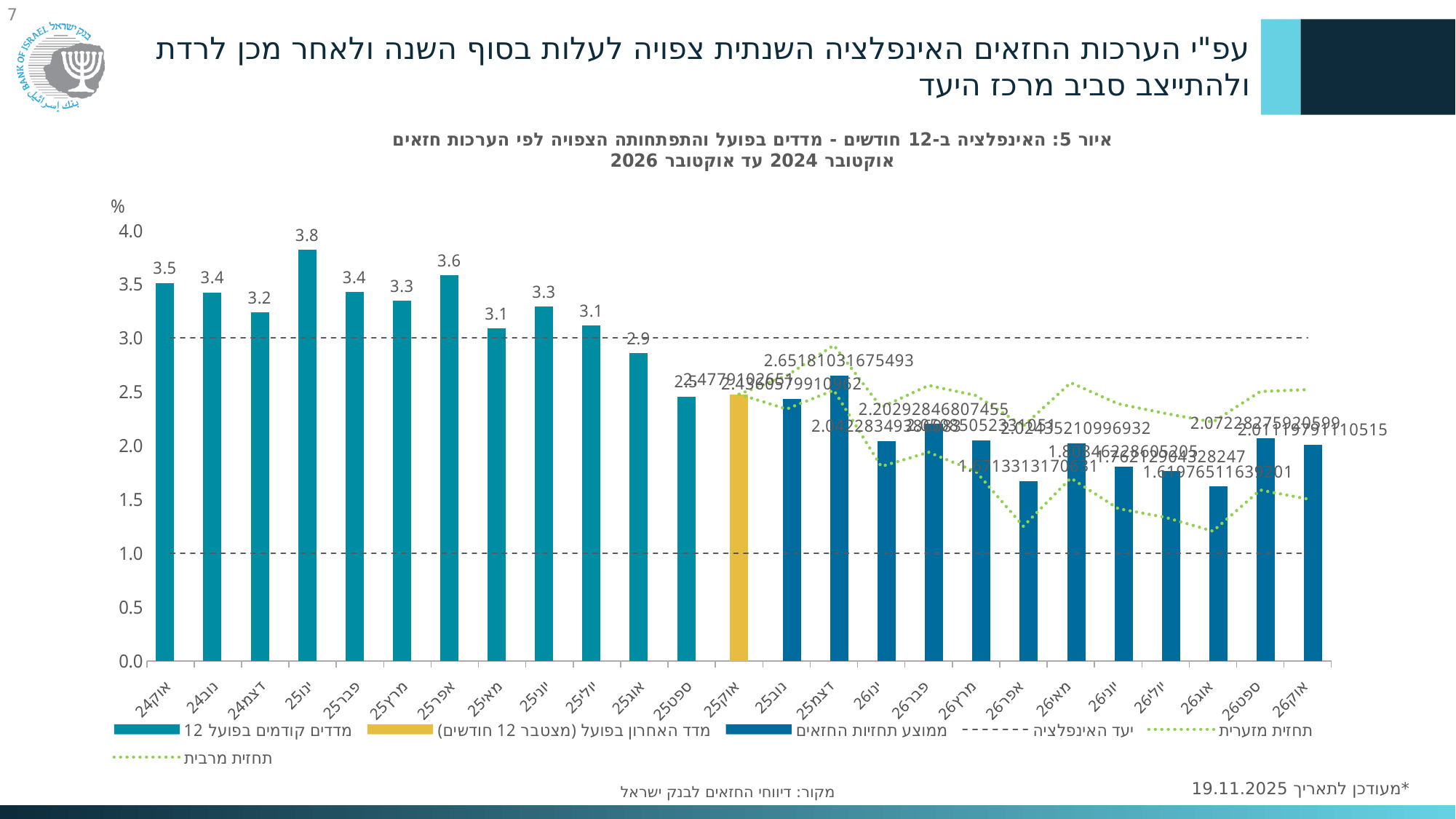
How many entries does the legend list? 6 Is the value for אוק26 greater or less than 1.5? greater Is the value for אפר26 greater or less than 2.0? less Do the bar values generally rise or fall from אוק24 to אוק26? fall What is the value for אוק24? 3.5 What kind of chart is this? combination bar and line chart Which is larger, the value for אפר25 or the value for מאי25? אפר25 What is the value for ינו25? 3.8 Which month has the highest bar? ינו25 What is the difference between the values for ינו25 and אוק24? 0.3 How many months (bars) are shown on the x axis? 25 What is the value for אוג25? 2.9